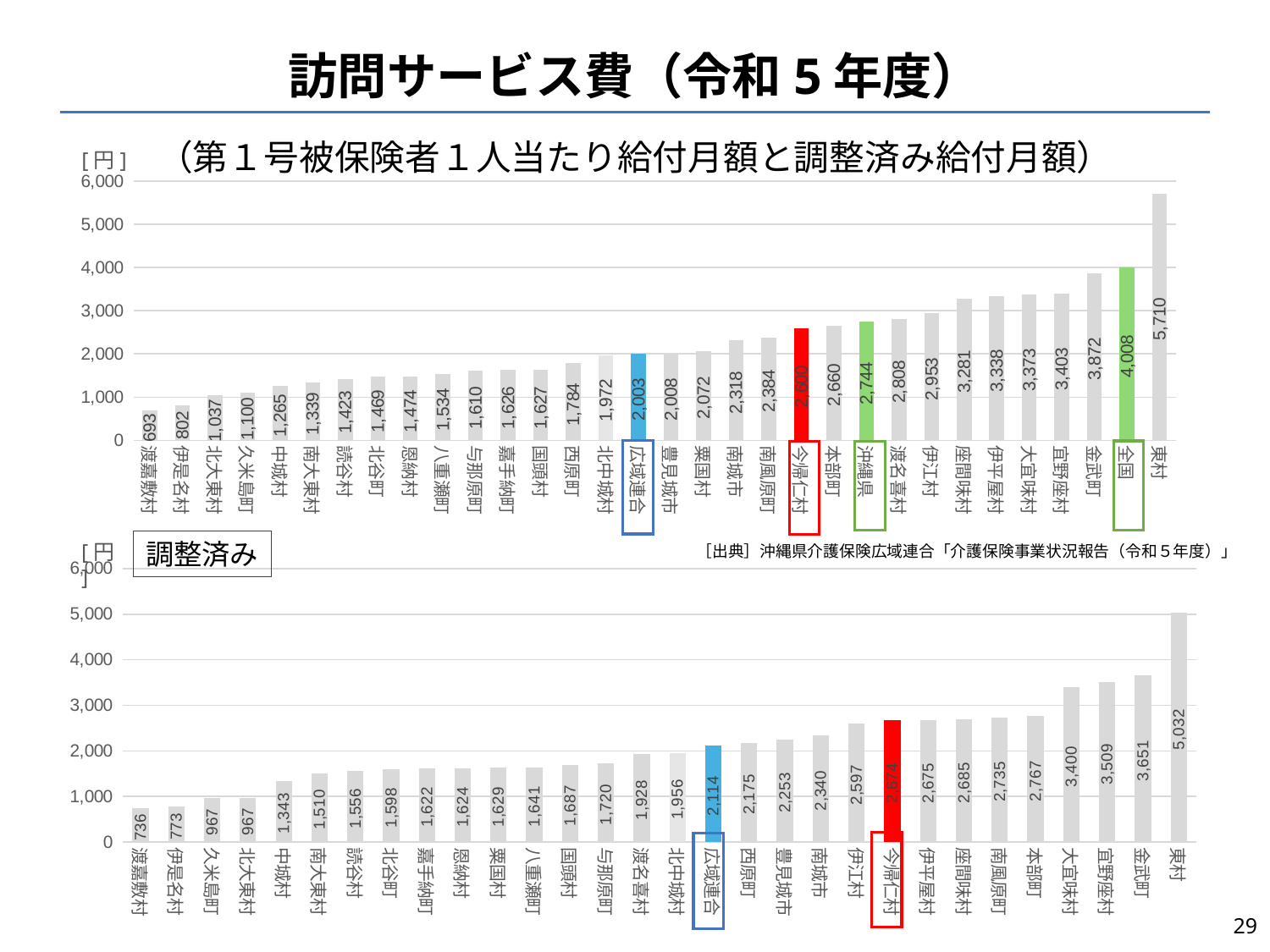
In the top chart (給付月額), what is the value for 全国? 4,008 In the top chart (給付月額), what is the value for 今帰仁村? 2,600 How many categories are plotted in the bottom chart (調整済み)? 30 In the bottom chart (調整済み), which is larger, the value for 金武町 or the value for 大宜味村? 金武町 In the bottom chart (調整済み), which category has the highest value? 東村 In the bottom chart (調整済み), is the value for 東村 greater or less than 4,000? greater In the top chart (給付月額), what is the difference between 全国 and 沖縄県? 1,264 In the bottom chart (調整済み), what is the value for 広域連合? 2,114 What kind of chart is the top chart (給付月額)? bar chart In the top chart (給付月額), which category has the lowest value? 渡嘉敷村 In the top chart (給付月額), what is the value for 東村? 5,710 In the bottom chart (調整済み), what is the value for 今帰仁村? 2,674